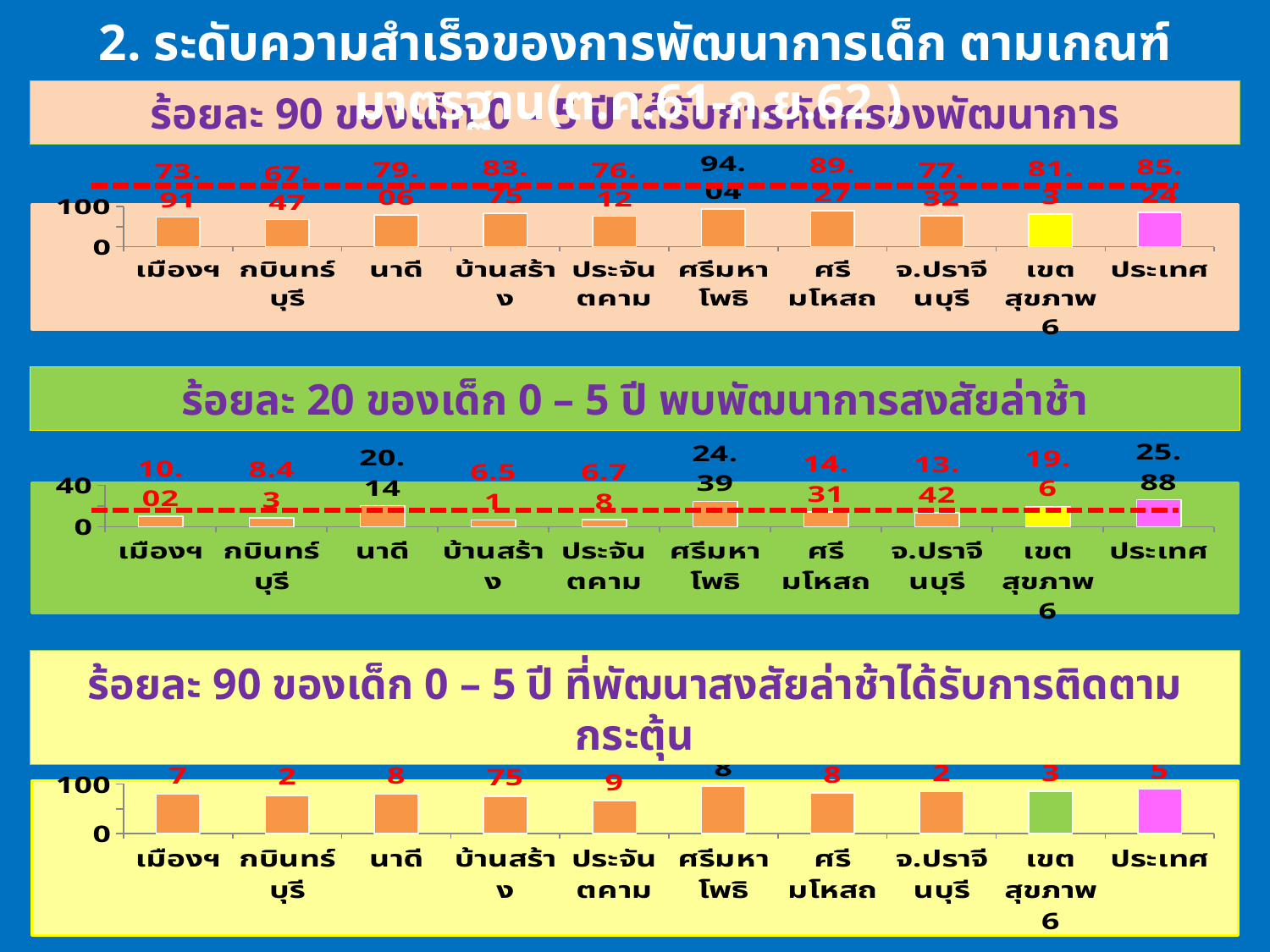
In the top chart (ร้อยละ 90 ของเด็ก 0 – 5 ปี ได้รับการคัดกรองพัฒนาการ), which category has the lowest value? กบินทร์บุรี In the middle chart (ร้อยละ 20 ของเด็ก 0 – 5 ปี พบพัฒนาการสงสัยล่าช้า), what is the value for นาดี? 20.14 In the middle chart (ร้อยละ 20 ของเด็ก 0 – 5 ปี พบพัฒนาการสงสัยล่าช้า), which category has the highest value? ประเทศ How many categories are shown on the x axis of the bottom chart (ร้อยละ 90 ของเด็ก 0 – 5 ปี ที่พัฒนาสงสัยล่าช้าได้รับการติดตามกระตุ้น)? 10 What kind of chart is the top chart (ร้อยละ 90 ของเด็ก 0 – 5 ปี ได้รับการคัดกรองพัฒนาการ)? bar chart In the middle chart (ร้อยละ 20 ของเด็ก 0 – 5 ปี พบพัฒนาการสงสัยล่าช้า), what is the difference between นาดี and เมืองฯ? 10.12 In the top chart (ร้อยละ 90 ของเด็ก 0 – 5 ปี ได้รับการคัดกรองพัฒนาการ), what is the difference between ศรีมหาโพธิ and ศรีมโหสถ? 4.77 In the bottom chart (ร้อยละ 90 ของเด็ก 0 – 5 ปี ที่พัฒนาสงสัยล่าช้าได้รับการติดตามกระตุ้น), is the value for ประจันตคาม greater or less than 100? less In the middle chart (ร้อยละ 20 ของเด็ก 0 – 5 ปี พบพัฒนาการสงสัยล่าช้า), which is larger, ศรีมหาโพธิ or ศรีมโหสถ? ศรีมหาโพธิ In the top chart (ร้อยละ 90 ของเด็ก 0 – 5 ปี ได้รับการคัดกรองพัฒนาการ), what is the value for ศรีมหาโพธิ? 94.04 In the middle chart (ร้อยละ 20 ของเด็ก 0 – 5 ปี พบพัฒนาการสงสัยล่าช้า), what is the value for ประเทศ? 25.88 In the top chart (ร้อยละ 90 ของเด็ก 0 – 5 ปี ได้รับการคัดกรองพัฒนาการ), which category has the highest value? ศรีมหาโพธิ